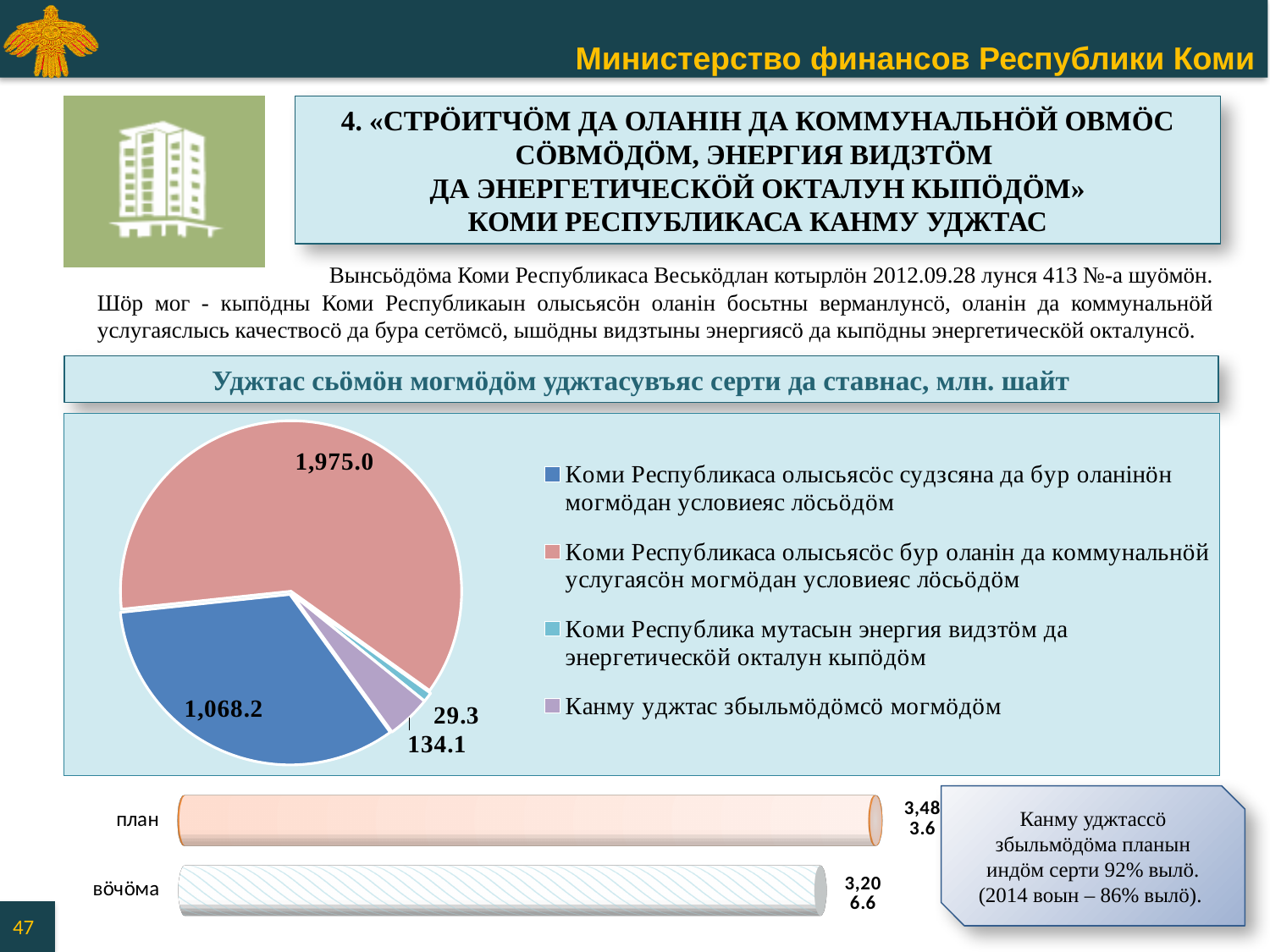
How many entries does the pie chart's legend list? 4 In the pie chart, what is the value of the largest slice? 1,975.0 How many slices does the pie chart have? 4 What kind of chart is the upper chart titled «Уджтас сьöмöн могмöдöм уджтасувъяс серти да ставнас, млн. шайт»? pie chart In the pie chart, what is the value for «Коми Республика мутасын энергия видзтöм да энергетическöй окталун кыпöдöм»? 29.3 In the pie chart, what is the value for «Канму уджтас збыльмöдöмсö могмöдöм»? 134.1 In the pie chart, what is the value of the smallest slice? 29.3 In the bar chart at the bottom of the slide, what is the value for «план»? 3,483.6 In the bar chart at the bottom of the slide, which bar is longer: «план» or «вöчöма»? план In the pie chart, what is the value for «Коми Республикаса олысьясöс судзсяна да бур оланінöн могмöдан условиеяс лöсьöдöм»? 1,068.2 In the pie chart, which is larger: the slice for «Канму уджтас збыльмöдöмсö могмöдöм» or the slice for «Коми Республика мутасын энергия видзтöм да энергетическöй окталун кыпöдöм»? Канму уджтас збыльмöдöмсö могмöдöм In the pie chart, what is the difference between the 1,975.0 slice and the 1,068.2 slice? 906.8